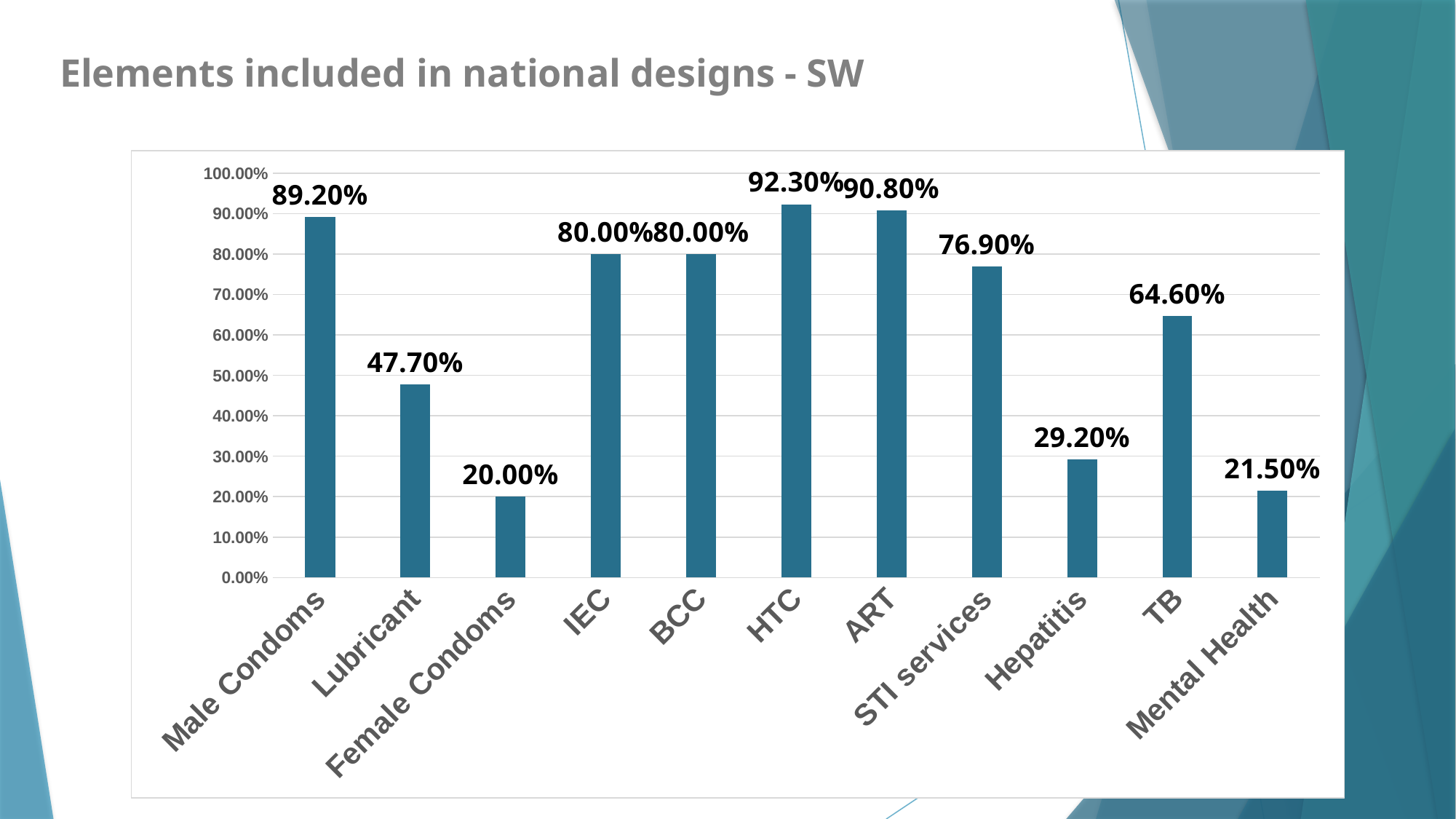
Which category has the highest value? HTC How many categories are shown on the x axis? 11 What is the value for STI services? 76.90% Is the value for Hepatitis greater or less than 40.00%? less What is the value for Lubricant? 47.70% Which category has the lowest value? Female Condoms What kind of chart is shown on the slide? bar chart What is the value for Mental Health? 21.50% What is the value for Male Condoms? 89.20% Which is larger, the value for Lubricant or the value for TB? TB What is the difference between the values for HTC and ART? 1.50% What is the difference between the values for TB and Hepatitis? 35.40%